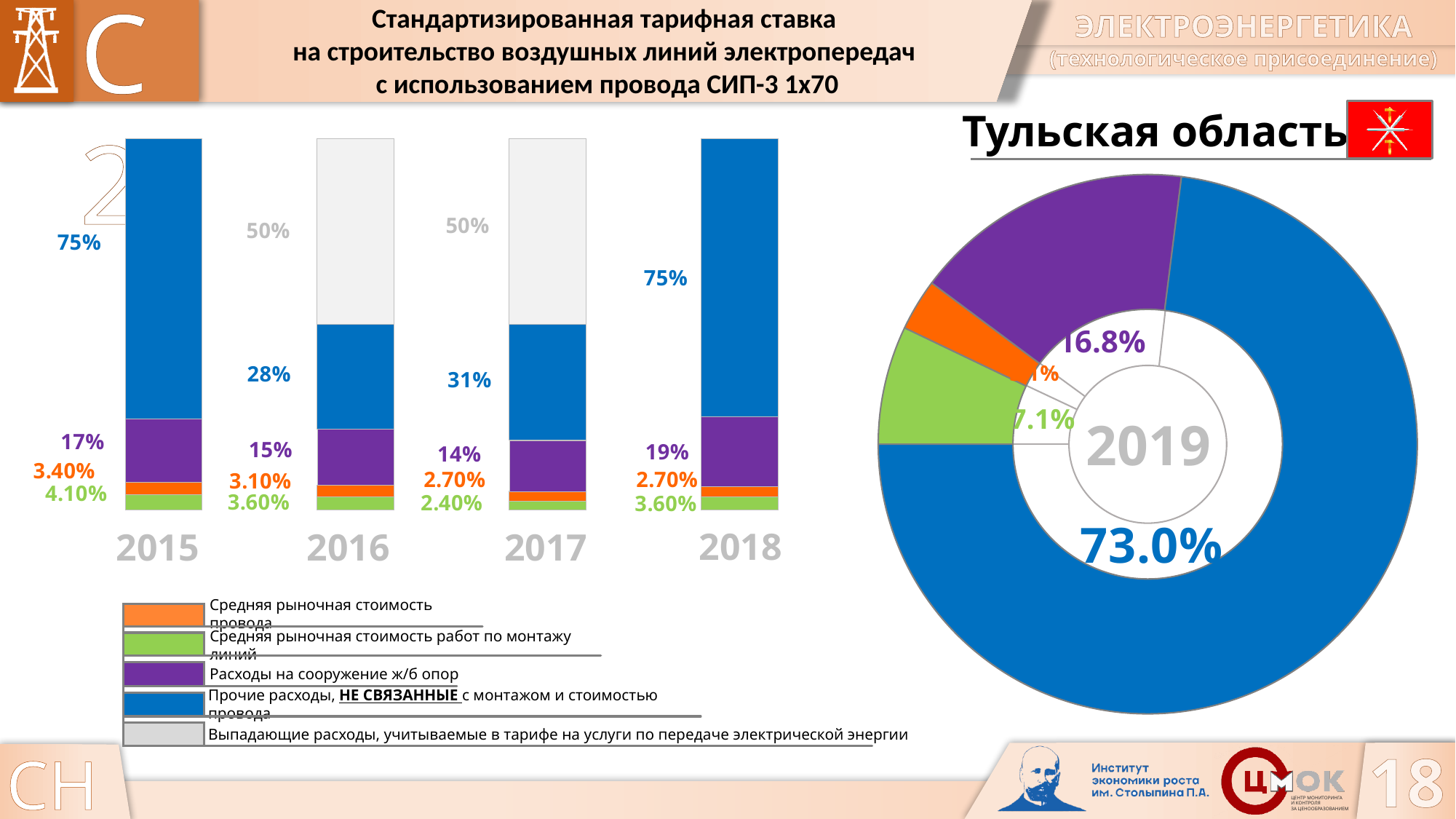
In the stacked bar chart on the left, what is the value of the green segment (Средняя рыночная стоимость работ по монтажу линий) for 2017? 2.40% In the stacked bar chart on the left, which year has the lowest value for the purple segment (Расходы на сооружение ж/б опор)? 2017 In the stacked bar chart on the left, what is the value of the grey segment (Выпадающие расходы) for 2017? 50% In the stacked bar chart on the left, what is the value of the orange segment (Средняя рыночная стоимость провода) for 2016? 3.10% How many years are shown on the x axis of the stacked bar chart on the left? 4 In the donut chart titled Тульская область, what is the value of the purple slice? 16.8% In the stacked bar chart on the left, what is the value of the blue segment (Прочие расходы, НЕ СВЯЗАННЫЕ с монтажом и стоимостью провода) for 2015? 75% In the stacked bar chart on the left, what is the value of the purple segment (Расходы на сооружение ж/б опор) for 2018? 19% In the stacked bar chart on the left, is the green segment larger in 2015 or in 2016? 2015 How many entries does the legend of the stacked bar chart on the left list? 5 In the donut chart titled Тульская область, what share does the blue slice have? 73.0% In the stacked bar chart on the left, what is the difference between the blue segment values for 2017 and 2016? 3%